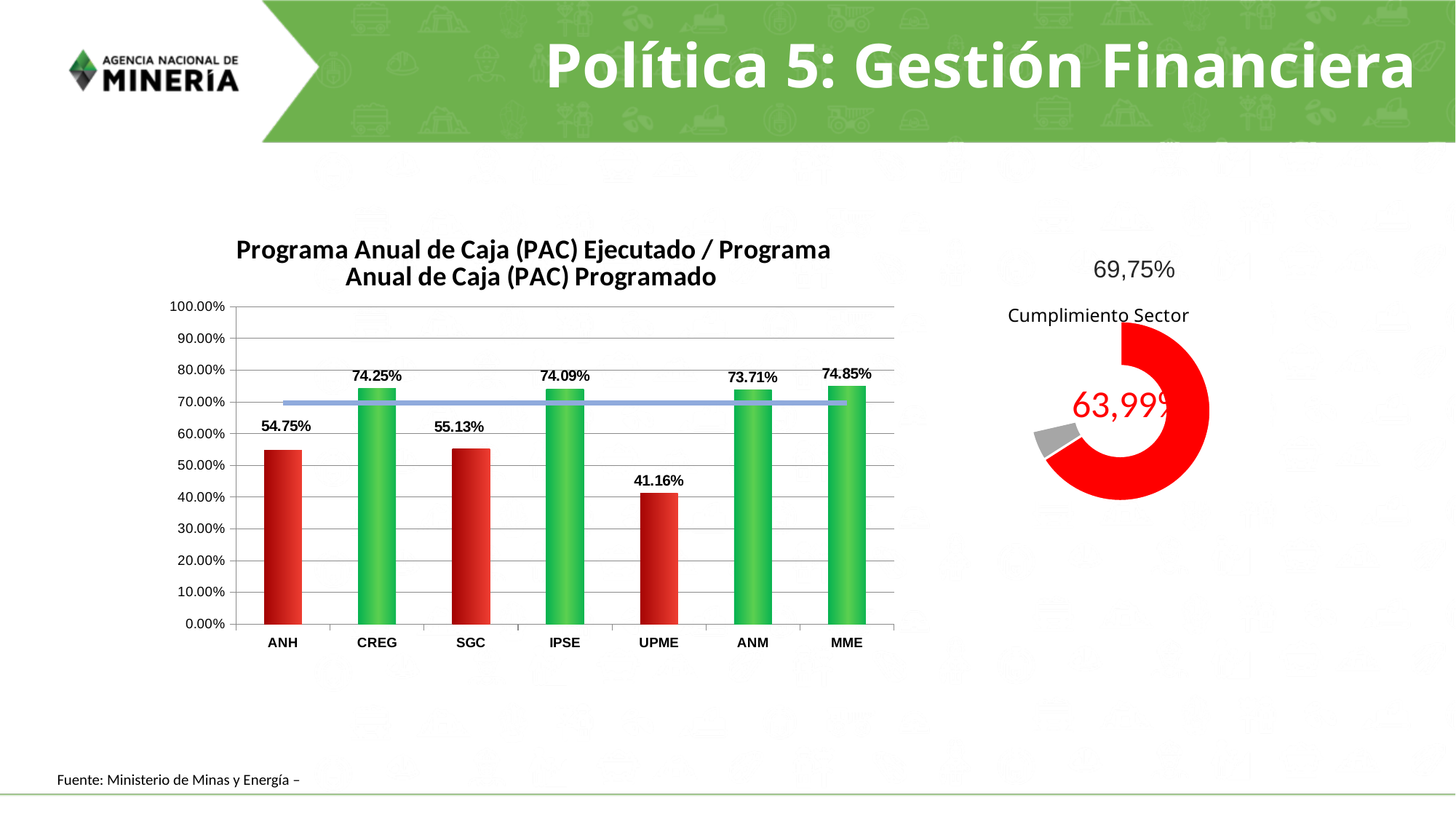
What kind of chart is the 'Programa Anual de Caja (PAC) Ejecutado / Programa Anual de Caja (PAC) Programado' chart? Combination bar and line chart In the bar chart, what is the value for UPME? 41.16% In the bar chart, what is the value for ANM? 73.71% How many entities are shown on the x axis of the bar chart? 7 In the bar chart 'Programa Anual de Caja (PAC) Ejecutado / Programa Anual de Caja (PAC) Programado', what is the value for ANH? 54.75% In the bar chart, which is larger, the value for SGC or the value for ANH? SGC In the bar chart, which entity has the highest value? MME What is the title of the doughnut chart on the right side of the slide? Cumplimiento Sector In the bar chart, what is the difference between the values for CREG and ANH? 19.50 percentage points In the bar chart, is the value for UPME greater or less than 50.00%? less In the bar chart, what is the value for IPSE? 74.09% In the bar chart, which entity has the lowest value? UPME